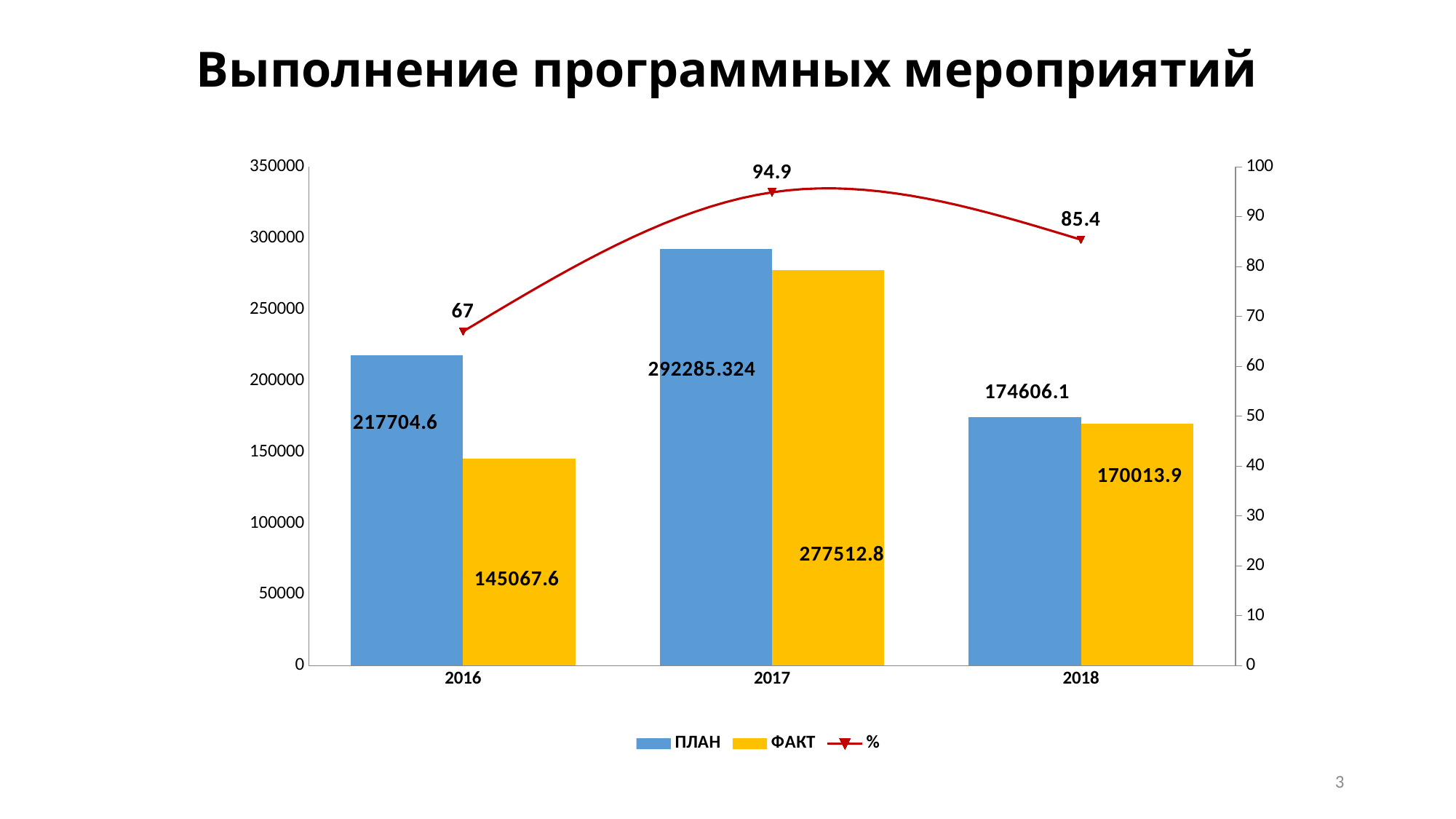
Which year has the lowest % value? 2016 What is the ПЛАН value for 2017? 292285.324 Is the ФАКТ value for 2018 greater or less than 200000? less Which is larger, the ПЛАН value for 2016 or the ПЛАН value for 2018? ПЛАН for 2016 What is the % value for 2018? 85.4 What is the difference between the ПЛАН and ФАКТ values for 2016? 72637 Which year has the highest ФАКТ value? 2017 What is the difference between the % values for 2017 and 2016? 27.9 What is the title of the chart? Выполнение программных мероприятий What is the ФАКТ value for 2016? 145067.6 How many series does the legend list? 3 How many years are shown on the x axis? 3